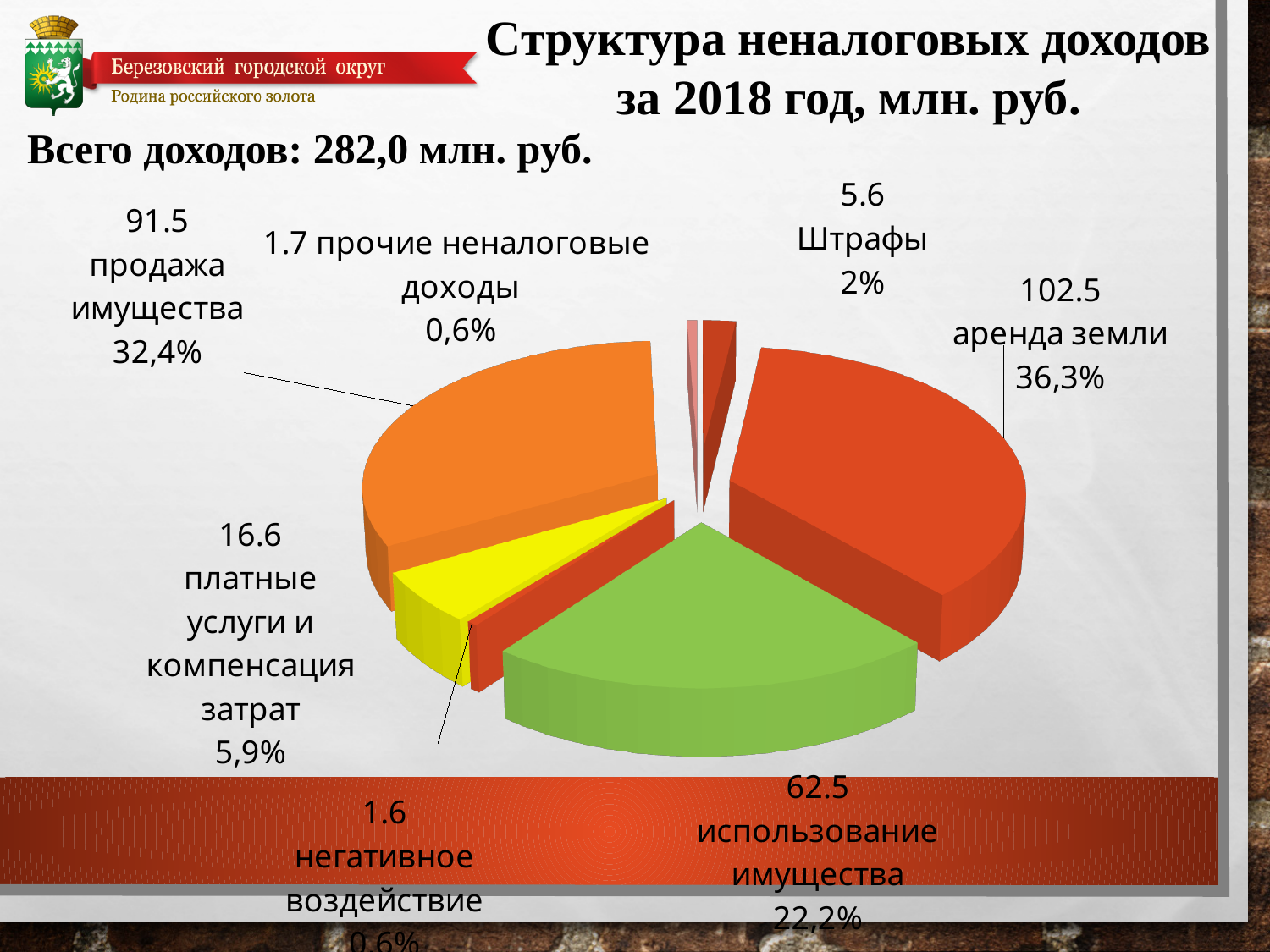
How many categories are shown in the pie chart? 7 What share of the pie does Штрафы represent? 2% What is the title of the chart? Структура неналоговых доходов за 2018 год, млн. руб. Which category has the largest value? аренда земли What is the value for аренда земли? 102.5 What total income is stated on the slide? 282,0 млн. руб. What kind of chart is shown on the slide? pie chart What is the value for использование имущества? 62.5 What share of the pie does продажа имущества represent? 32,4% Which is larger, продажа имущества or использование имущества? продажа имущества What is the value for платные услуги и компенсация затрат? 16.6 What is the difference between the values for аренда земли and продажа имущества? 11.0